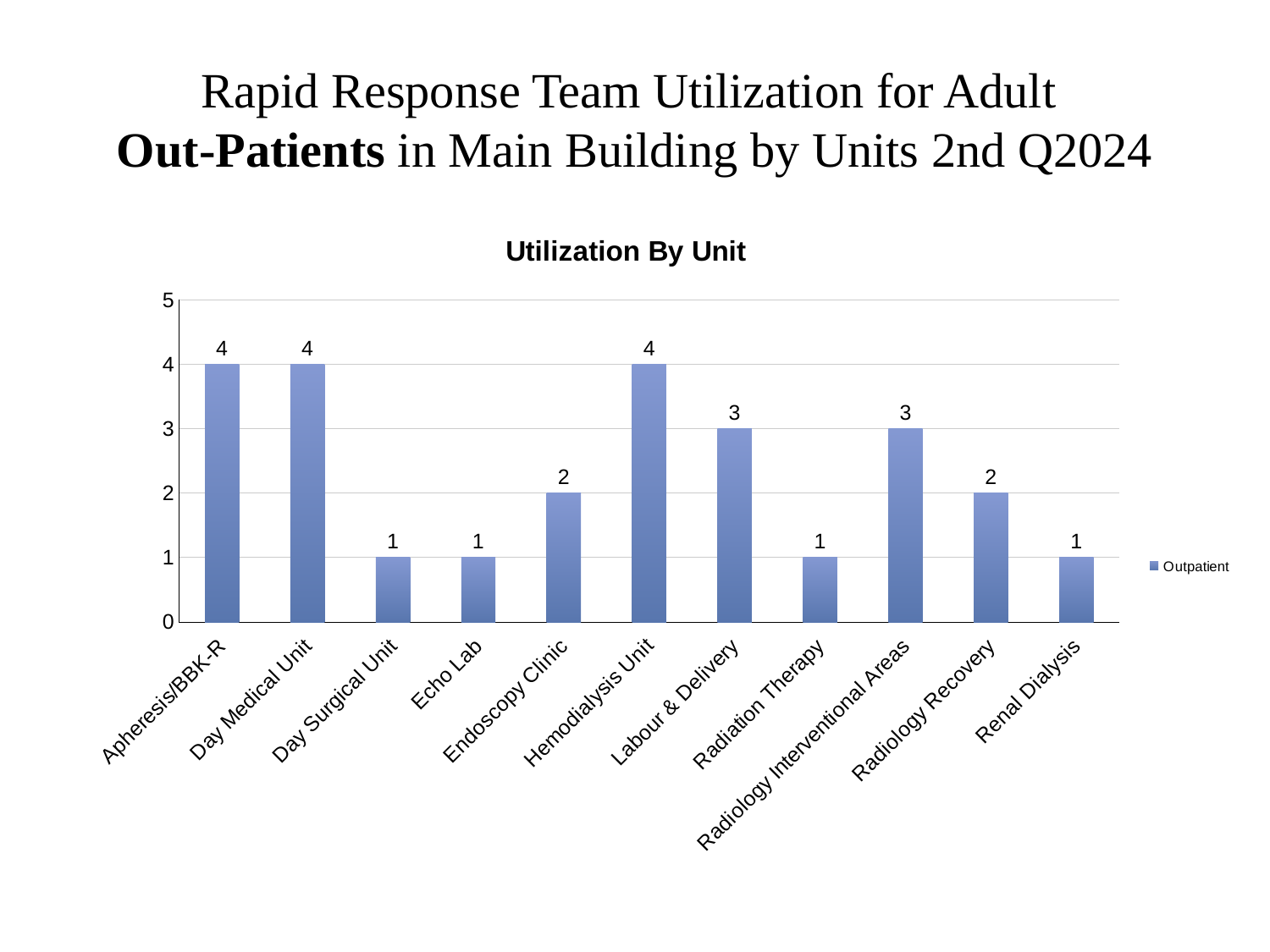
What is the value for Renal Dialysis? 1 What is the difference between the values for Day Medical Unit and Day Surgical Unit? 3 What is the value for Endoscopy Clinic? 2 What is the value for Radiology Interventional Areas? 3 How many series does the legend list? 1 What kind of chart is shown? bar chart Which is larger, the value for Labour & Delivery or the value for Radiology Recovery? Labour & Delivery How many categories are shown on the x axis? 11 What is the value for Hemodialysis Unit? 4 Which category has the lowest value among Labour & Delivery, Radiation Therapy and Radiology Recovery? Radiation Therapy Is the value for Apheresis/BBK-R greater or less than 3? greater What is the title of the chart? Utilization By Unit